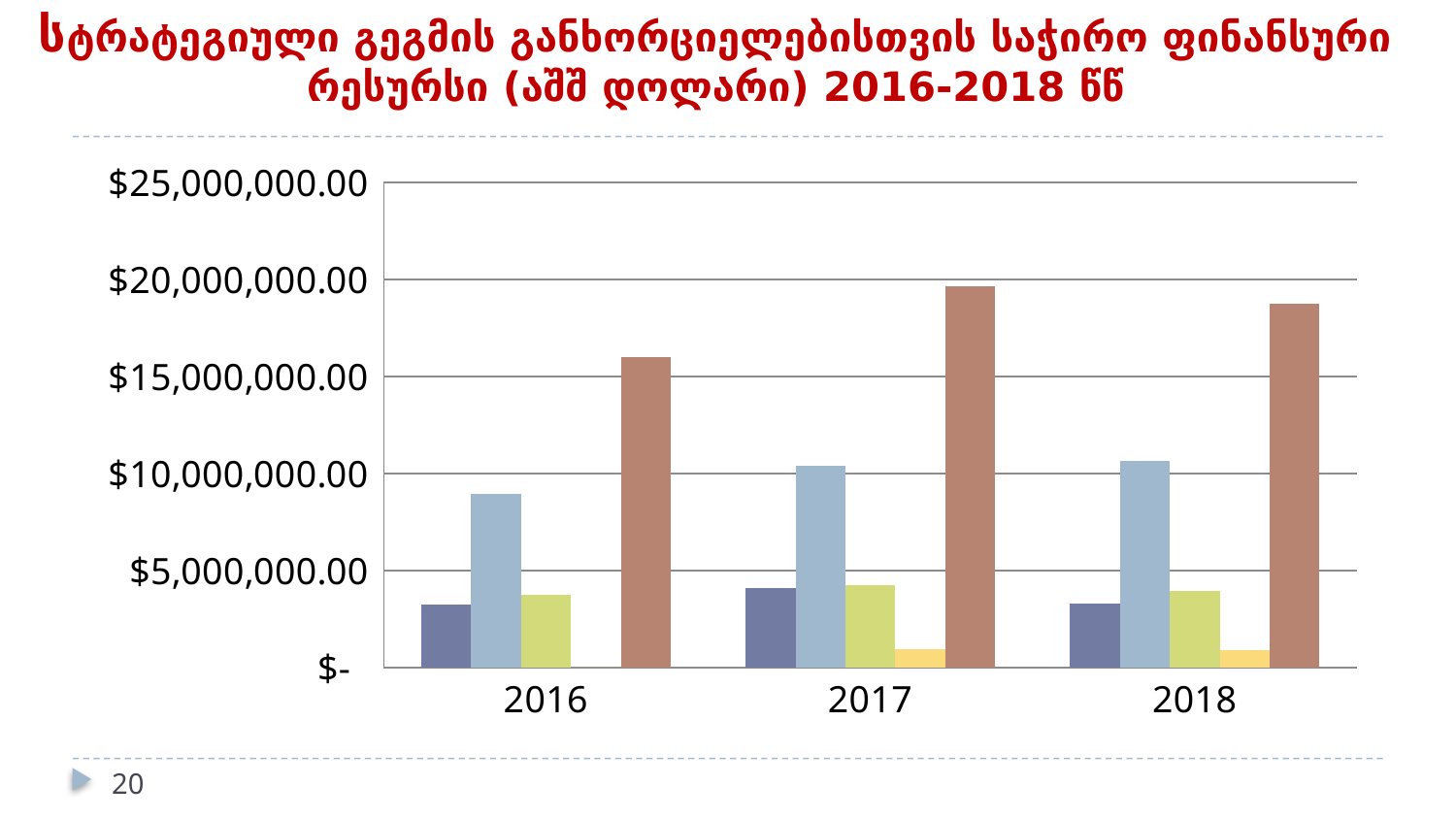
Is the light blue bar for 2016 greater or less than $10,000,000.00? less Which is larger: the brown bar for 2017 or the brown bar for 2018? 2017 How many years (categories) are shown on the x axis of the chart? 3 What is the highest value labelled on the y axis of the chart? $25,000,000.00 Which year has the tallest brown bar? 2017 Is the dark blue bar for 2017 greater or less than $5,000,000.00? less What kind of chart is shown on the slide? bar chart Which year has the shortest brown bar? 2016 How many bars are shown in the 2017 group? 5 Is the brown bar for 2018 greater or less than $20,000,000.00? less In 2016, which is larger: the light blue bar or the dark blue bar? the light blue bar